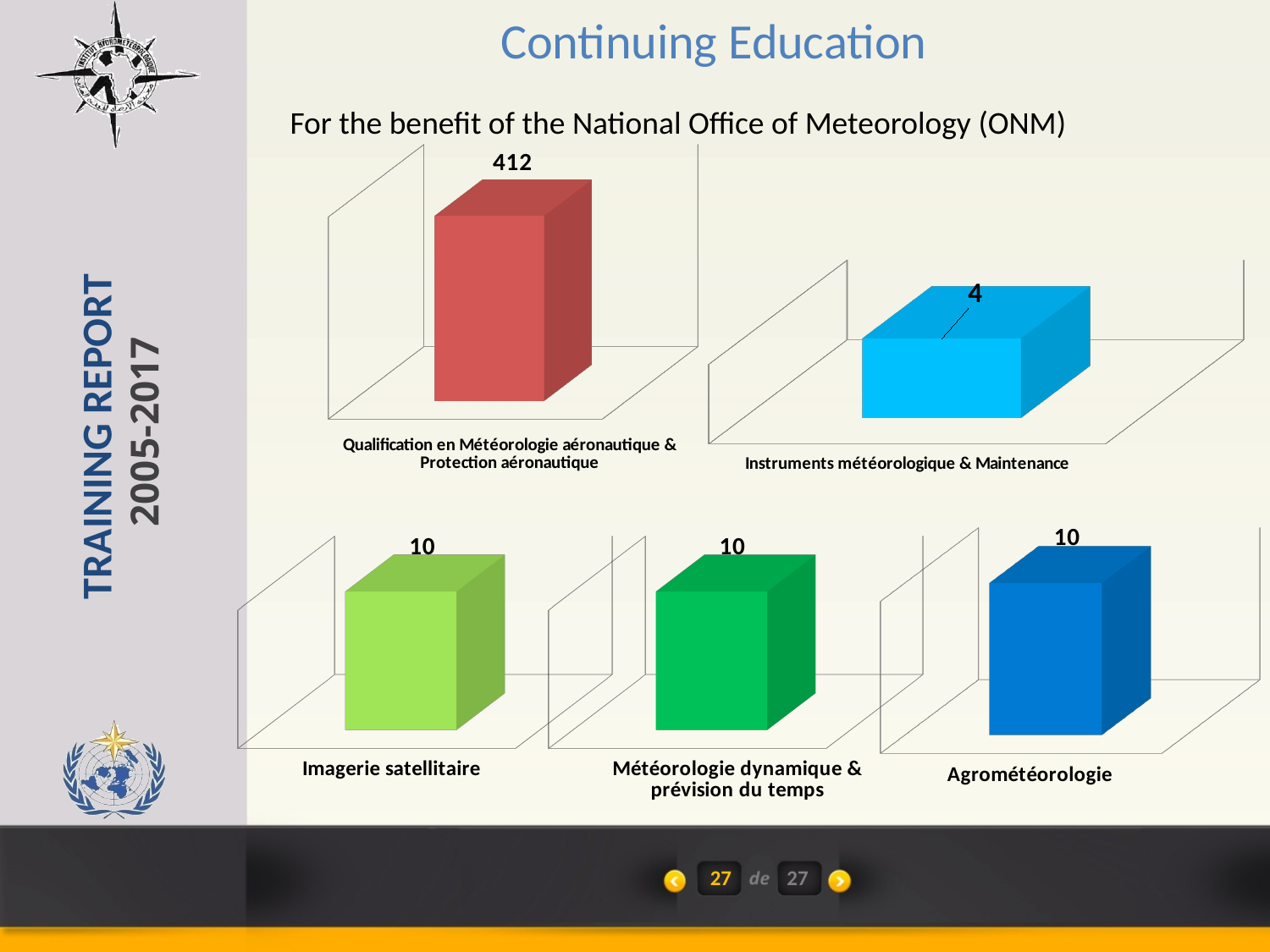
In the chart labelled "Qualification en Météorologie aéronautique & Protection aéronautique", what value is shown on the bar? 412 How many separate charts are shown on the slide? 5 In the chart labelled "Imagerie satellitaire", what value is shown on the bar? 10 In the chart labelled "Agrométéorologie", what value is shown on the bar? 10 In the chart labelled "Instruments météorologique & Maintenance", what value is shown on the bar? 4 What kind of chart is the "Imagerie satellitaire" chart? Bar chart Which is larger: the value in the "Agrométéorologie" chart or the value in the "Instruments météorologique & Maintenance" chart? Agrométéorologie What is the difference between the value in the "Qualification en Météorologie aéronautique & Protection aéronautique" chart and the value in the "Instruments météorologique & Maintenance" chart? 408 In the chart labelled "Météorologie dynamique & prévision du temps", what value is shown on the bar? 10 Across the five charts on the slide, which training area has the highest value? Qualification en Météorologie aéronautique & Protection aéronautique What is the difference between the value in the "Imagerie satellitaire" chart and the value in the "Instruments météorologique & Maintenance" chart? 6 Across the five charts on the slide, which training area has the lowest value? Instruments météorologique & Maintenance